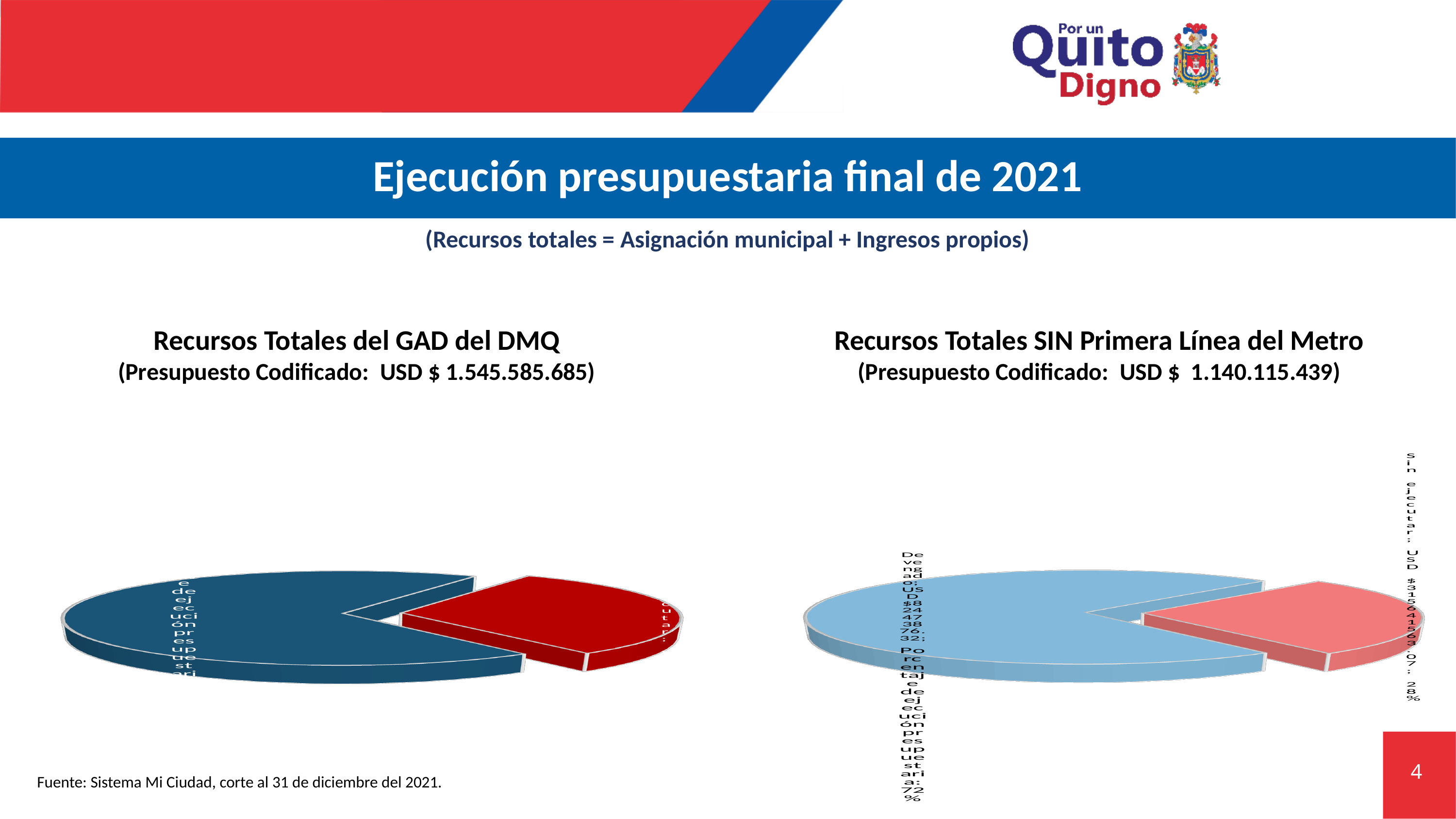
What 'Presupuesto Codificado' amount is given in the title of the left chart, 'Recursos Totales del GAD del DMQ'? USD $ 1.545.585.685 In the 'Recursos Totales SIN Primera Línea del Metro' chart, what share of the pie is 'Devengado'? 72% What kind of chart is the 'Recursos Totales del GAD del DMQ' chart on the left? pie chart What kind of chart is the 'Recursos Totales SIN Primera Línea del Metro' chart on the right? pie chart In the 'Recursos Totales del GAD del DMQ' chart on the left, which slice is larger, the dark blue one or the red one? the dark blue one In the 'Recursos Totales SIN Primera Línea del Metro' chart, which slice is larger, 'Devengado' or 'Sin ejecutar'? Devengado How many slices does the 'Recursos Totales del GAD del DMQ' pie chart have? 2 How many slices does the 'Recursos Totales SIN Primera Línea del Metro' pie chart have? 2 In the 'Recursos Totales SIN Primera Línea del Metro' chart, which slice is the smallest? Sin ejecutar What 'Presupuesto Codificado' amount is given in the title of the right chart, 'Recursos Totales SIN Primera Línea del Metro'? USD $ 1.140.115.439 In the 'Recursos Totales SIN Primera Línea del Metro' chart, what share of the pie is 'Sin ejecutar'? 28% In the 'Recursos Totales SIN Primera Línea del Metro' chart, by how many percentage points does the 'Devengado' share exceed the 'Sin ejecutar' share? 44